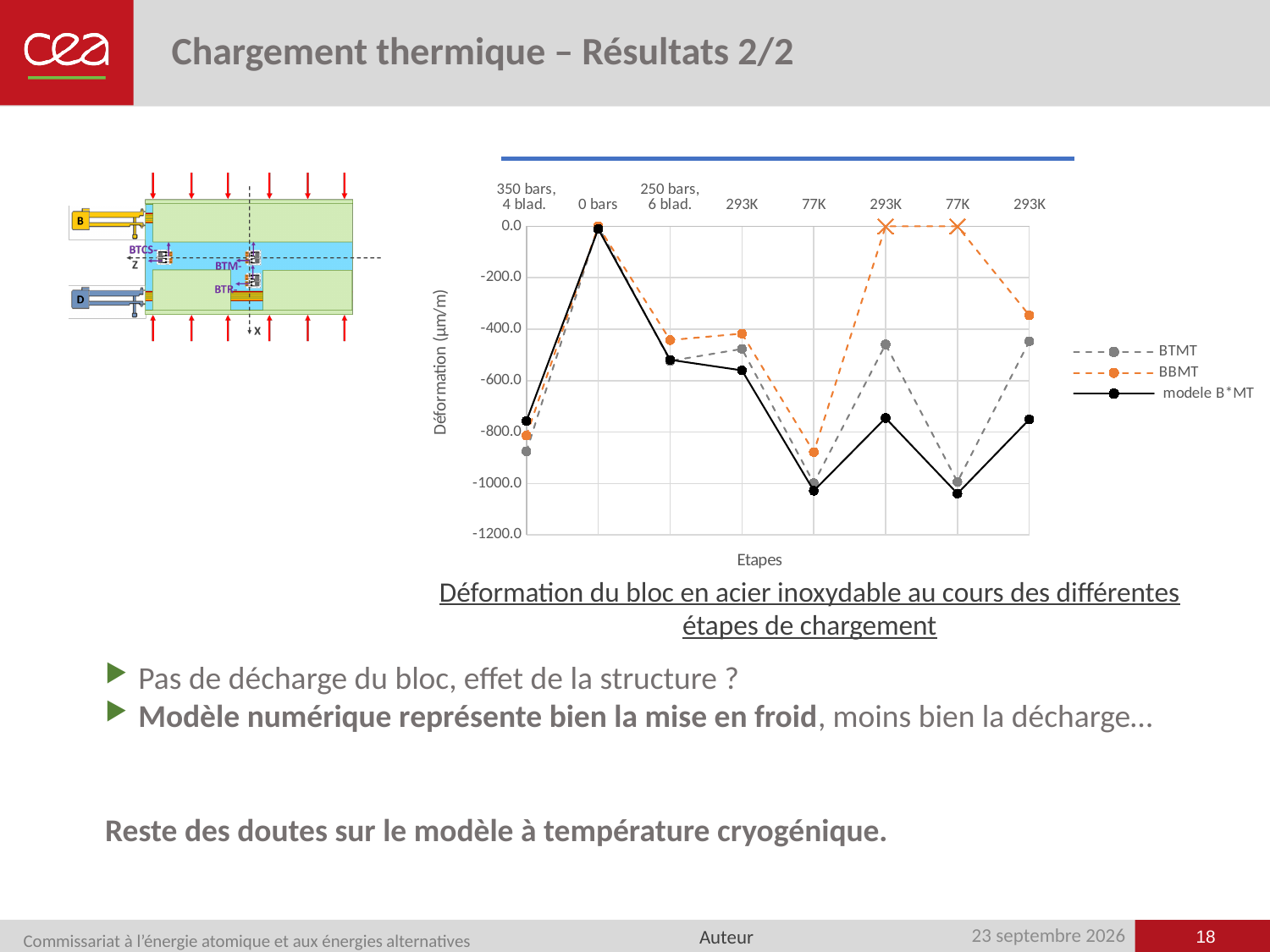
Is the value of BBMT at the last 293K stage greater or less than -400.0? greater How many series does the chart legend list? 3 At the second 293K stage, which series has the higher value, BBMT or modele B*MT? BBMT Which series in the chart is drawn with a solid black line? modele B*MT What is the title of the y axis of the chart? Déformation (µm/m) What kind of chart is shown on the slide? line chart Do the values of all three series rise or fall from the first 293K stage to the first 77K stage? fall How many stages (points) are plotted along the x axis of the chart? 8 Is the value of modele B*MT at the first 77K stage greater or less than -1000.0? less At the last 293K stage, which series has the higher value, BTMT or modele B*MT? BTMT Is the value of BBMT at the first 77K stage greater or less than -800.0? less